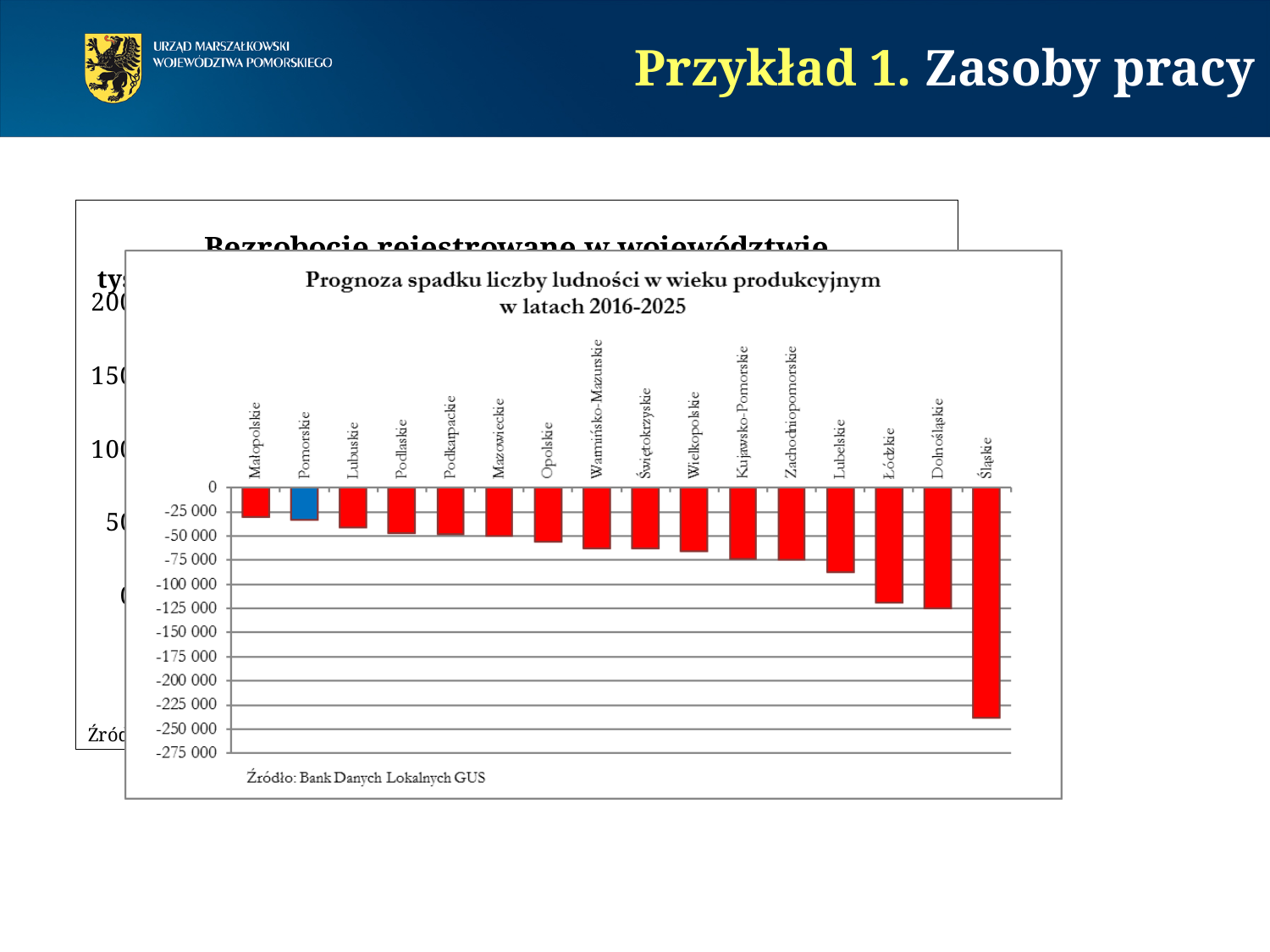
In the chart 'Prognoza spadku liczby ludności w wieku produkcyjnym', do the bars get longer or shorter moving from left to right along the x axis? longer What source is cited below the chart 'Prognoza spadku liczby ludności w wieku produkcyjnym'? Bank Danych Lokalnych GUS In the chart 'Prognoza spadku liczby ludności w wieku produkcyjnym', is the value for Opolskie greater or less than -50 000? less In the chart 'Prognoza spadku liczby ludności w wieku produkcyjnym', is the value for Śląskie greater or less than -200 000? less In the chart 'Prognoza spadku liczby ludności w wieku produkcyjnym', which voivodeship has the largest projected decline (the longest bar)? Śląskie In the chart 'Prognoza spadku liczby ludności w wieku produkcyjnym', is the value for Łódzkie greater or less than -100 000? less In the chart 'Prognoza spadku liczby ludności w wieku produkcyjnym', which voivodeship has the smallest projected decline (the shortest bar)? Małopolskie What kind of chart is 'Prognoza spadku liczby ludności w wieku produkcyjnym w latach 2016-2025'? bar chart In the chart 'Prognoza spadku liczby ludności w wieku produkcyjnym', which voivodeship's bar is coloured blue instead of red? Pomorskie In the chart 'Prognoza spadku liczby ludności w wieku produkcyjnym', which has the larger projected decline, Lubelskie or Łódzkie? Łódzkie How many voivodeships (categories) are shown in the chart 'Prognoza spadku liczby ludności w wieku produkcyjnym w latach 2016-2025'? 16